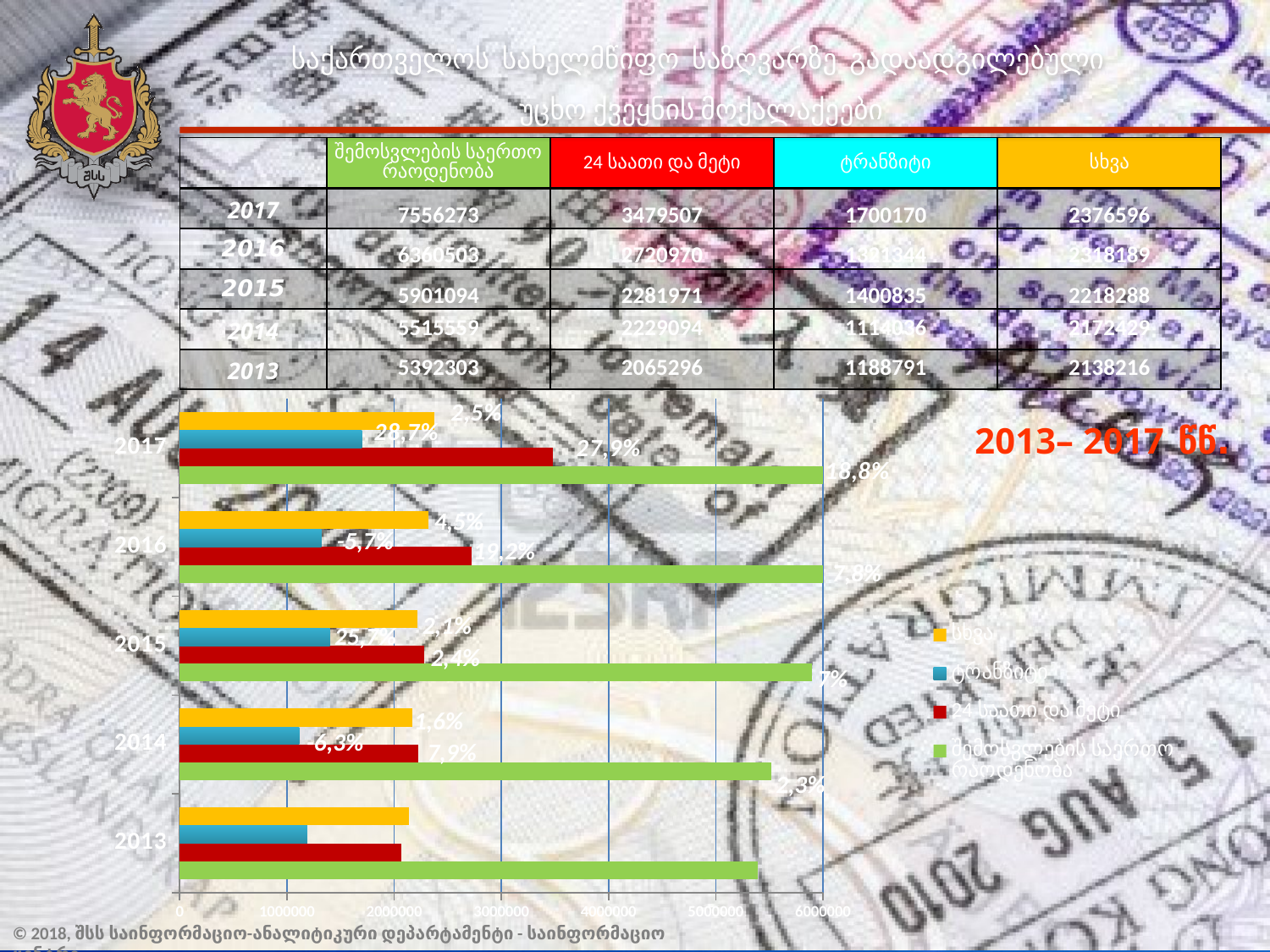
What kind of chart is shown on the slide? bar chart What percentage label is shown on the ტრანზიტი bar for 2017? 28,7% In which year is the შემოსვლების საერთო რაოდენობა bar the longest? 2017 Is the 24 საათი და მეტი bar for 2017 greater or less than 3000000? greater What percentage label is shown on the 24 საათი და მეტი bar for 2016? 19,2% Do the შემოსვლების საერთო რაოდენობა bars rise or fall from 2013 to 2017? rise For 2017, which is larger: the 24 საათი და მეტი bar or the ტრანზიტი bar? 24 საათი და მეტი How many series does the chart legend list? 4 How many years are plotted on the chart? 5 What percentage label is shown on the შემოსვლების საერთო რაოდენობა bar for 2017? 18,8% What percentage label is shown on the ტრანზიტი bar for 2016? -5,7% Is the ტრანზიტი bar for 2014 greater or less than 2000000? less